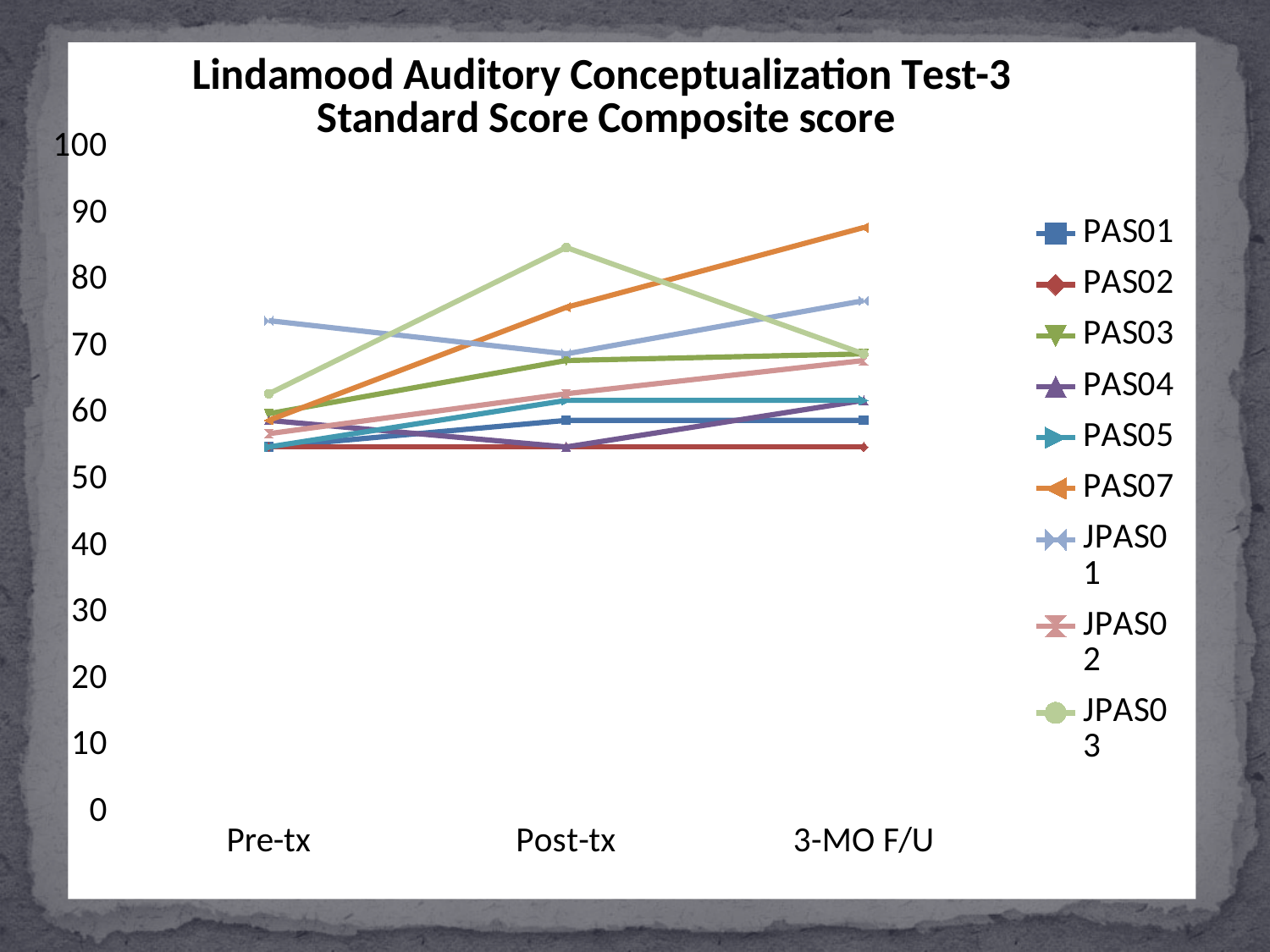
Which series has the highest value at Pre-tx? JPAS01 Is the value for JPAS03 at Post-tx greater or less than 80? greater How many time points are shown on the x axis? 3 How many series does the legend list? 9 Is the value for PAS02 at Pre-tx greater or less than 60? less At Pre-tx, which is larger: the value for JPAS01 or the value for PAS03? JPAS01 Is the value for PAS07 at 3-MO F/U greater or less than 80? greater Does the PAS07 line rise or fall from Pre-tx to 3-MO F/U? rises Which series has the highest value at 3-MO F/U? PAS07 What kind of chart is shown on the slide? line chart Does the JPAS03 line rise or fall from Post-tx to 3-MO F/U? falls Which series has the highest value at Post-tx? JPAS03